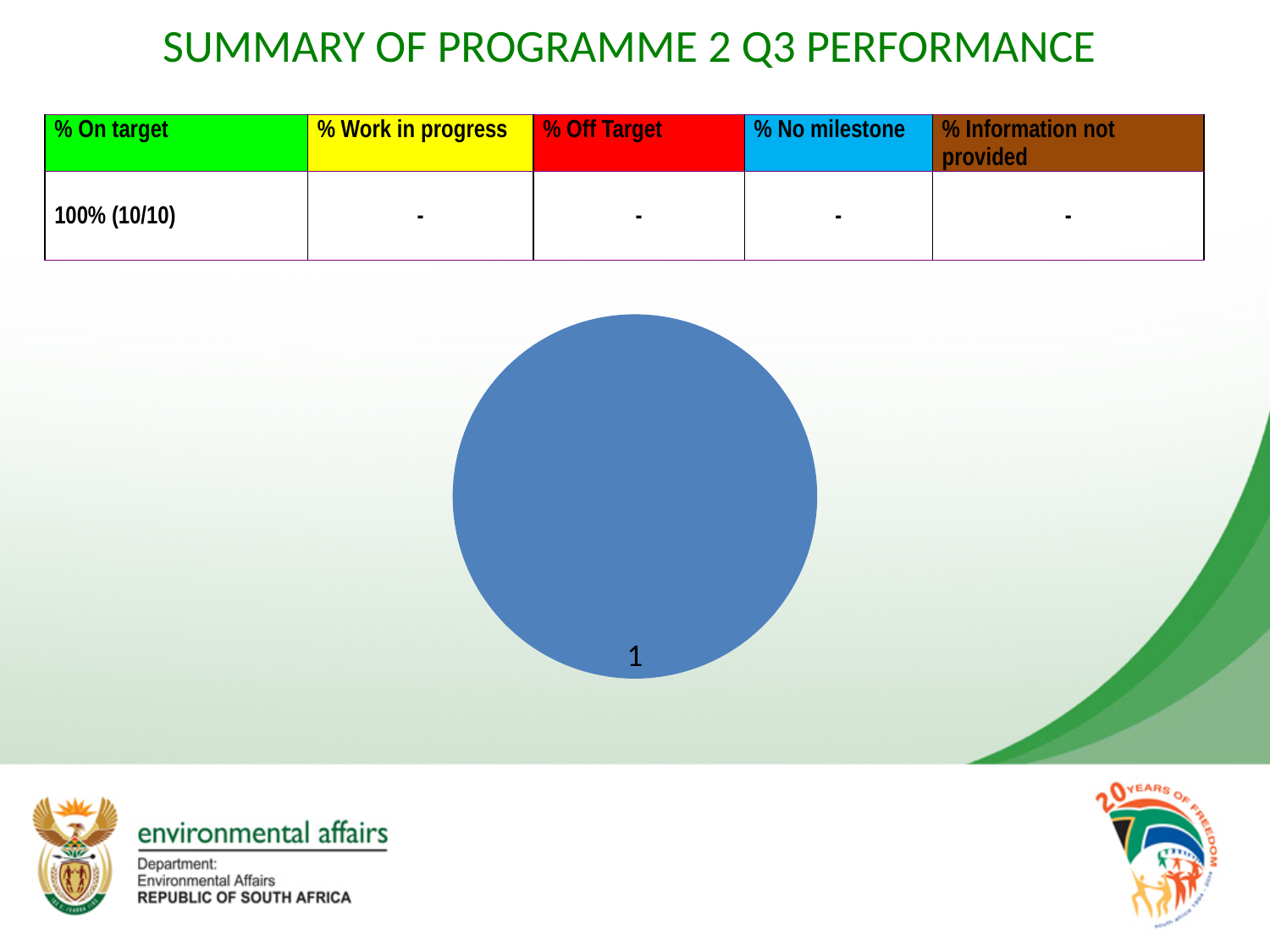
What data label is printed on the pie chart's slice? 1 Does the pie chart display a legend? No What share of the pie does the single slice represent? 100% What colour is the slice of the pie chart? blue How many slices does the pie chart have? 1 What kind of chart is shown on the slide? pie chart